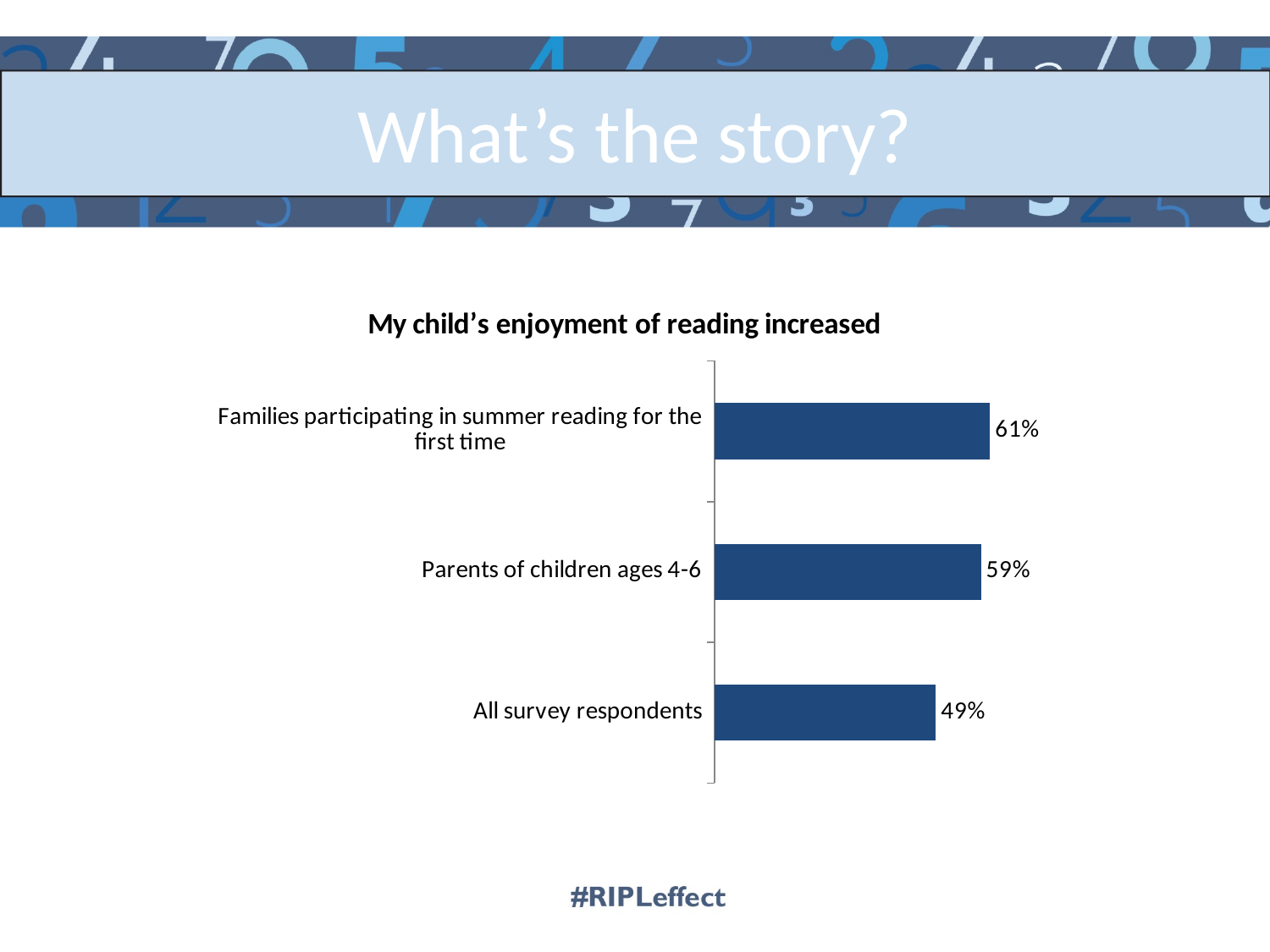
How many categories are shown in the chart? 3 Which is larger, the value for Parents of children ages 4-6 or the value for All survey respondents? Parents of children ages 4-6 What is the value for Parents of children ages 4-6? 59% What is the title of the chart? My child's enjoyment of reading increased What kind of chart is shown on the slide? Bar chart What is the difference between the value for Parents of children ages 4-6 and the value for All survey respondents? 10% What is the value for All survey respondents? 49% Which category has the highest value? Families participating in summer reading for the first time What is the difference between the value for Families participating in summer reading for the first time and the value for All survey respondents? 12% What is the value for Families participating in summer reading for the first time? 61% What colour are the bars in the chart? Dark blue Which category has the lowest value? All survey respondents